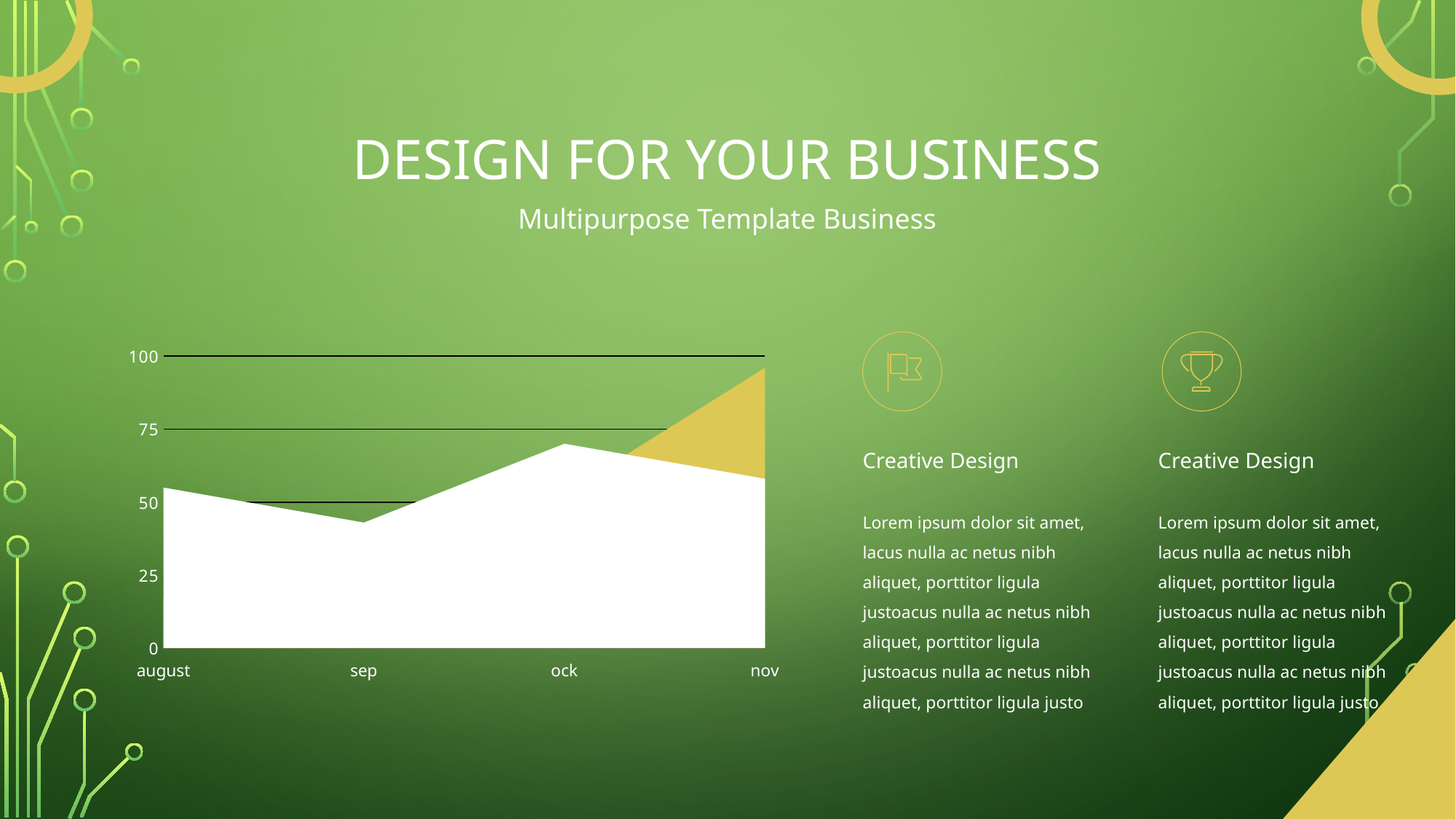
Which category on the chart has the lowest value? sep Which is larger, the value for sep or the value for ock? ock Does the value rise or fall from august to sep? fall Is the value for ock greater or less than 75? less Is the value for august greater or less than 75? less Is the value for ock greater or less than 50? greater How many categories are shown on the x axis of the chart? 4 Does the value rise or fall from sep to ock? rise What is the highest value labelled on the y axis of the chart? 100 What kind of chart is shown on the slide? area chart